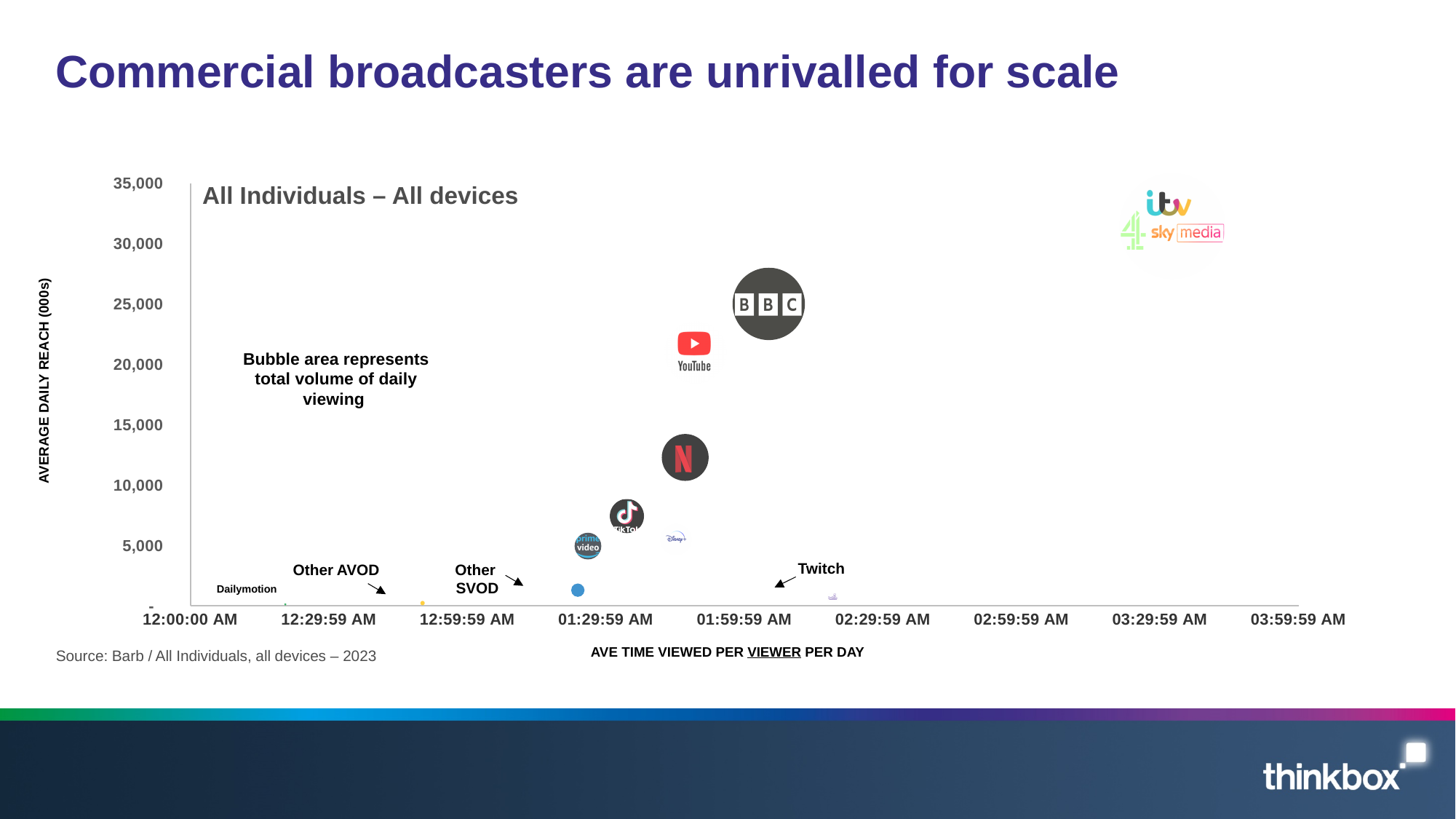
Is the average daily reach for TikTok greater or less than 10,000? less Which has a longer average time viewed per viewer per day, Twitch or Dailymotion? Twitch Which has a higher average daily reach, YouTube or TikTok? YouTube What does the horizontal axis of the chart measure? Ave time viewed per viewer per day Is the average daily reach for Netflix greater or less than 15,000? less What does the vertical axis of the chart measure? Average daily reach (000s) What kind of chart is shown on the slide? Bubble chart Is the average daily reach for YouTube greater or less than 20,000? greater Which has a higher average daily reach, BBC or Netflix? BBC Which platform has the highest average daily reach on the chart? ITV / Channel 4 / Sky Media (commercial broadcasters)